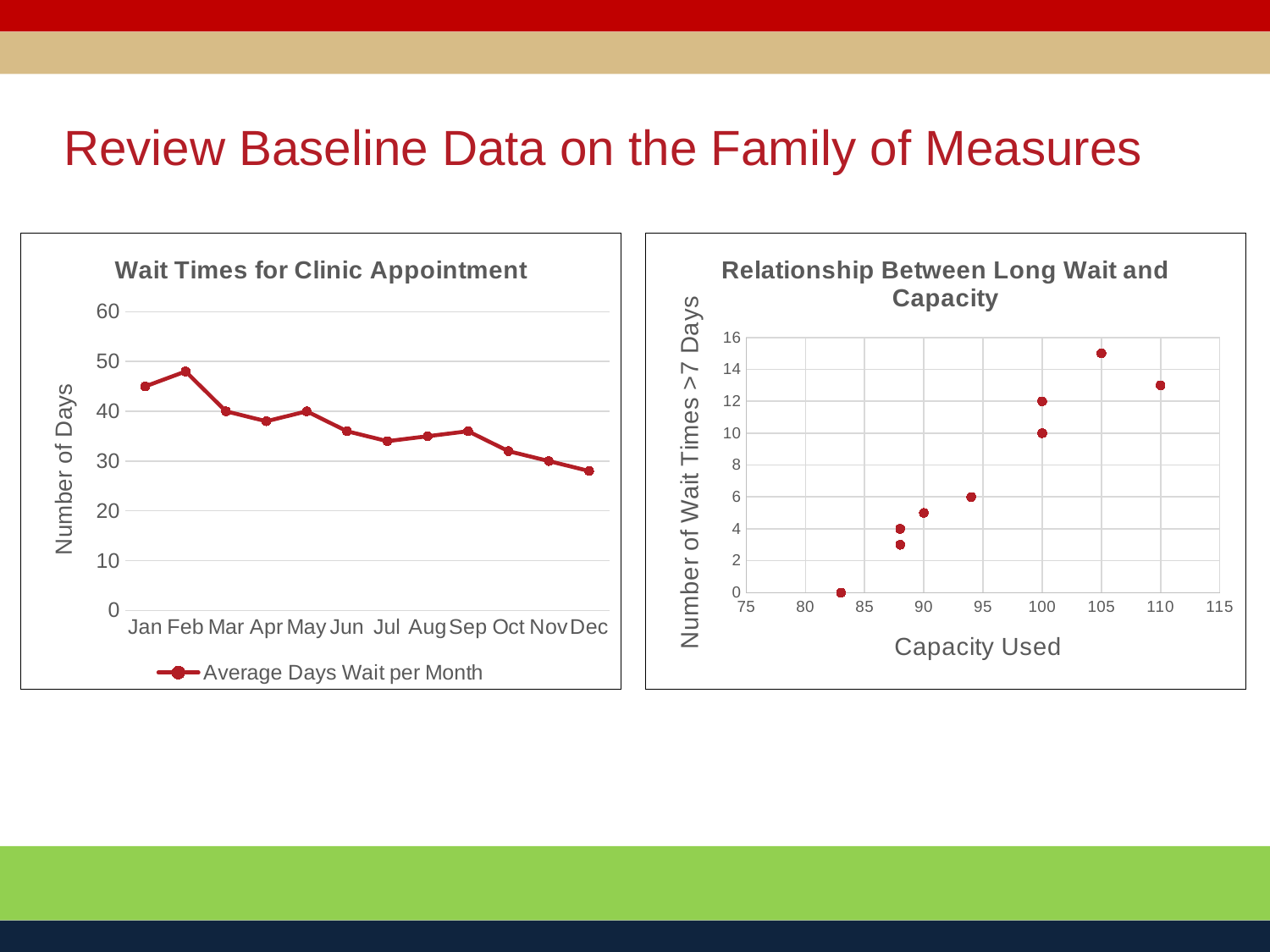
In the 'Relationship Between Long Wait and Capacity' chart, how many data points are plotted? 9 In the 'Wait Times for Clinic Appointment' chart, which month has the highest average days wait? Feb In the 'Wait Times for Clinic Appointment' chart, is the value for Dec greater or less than 30? less In the 'Wait Times for Clinic Appointment' chart, how many series does the legend list? 1 What is the legend entry in the 'Wait Times for Clinic Appointment' chart? Average Days Wait per Month In the 'Wait Times for Clinic Appointment' chart, which is larger, the value for Jan or the value for Jul? Jan In the 'Wait Times for Clinic Appointment' chart, do the values generally rise or fall from Jan to Dec? fall In the 'Wait Times for Clinic Appointment' chart, which month has the lowest average days wait? Dec In the 'Wait Times for Clinic Appointment' chart, how many months are plotted on the x axis? 12 What kind of chart is the 'Relationship Between Long Wait and Capacity' chart? scatter chart What kind of chart is the 'Wait Times for Clinic Appointment' chart? line chart In the 'Wait Times for Clinic Appointment' chart, is the value for Jan greater or less than 40? greater